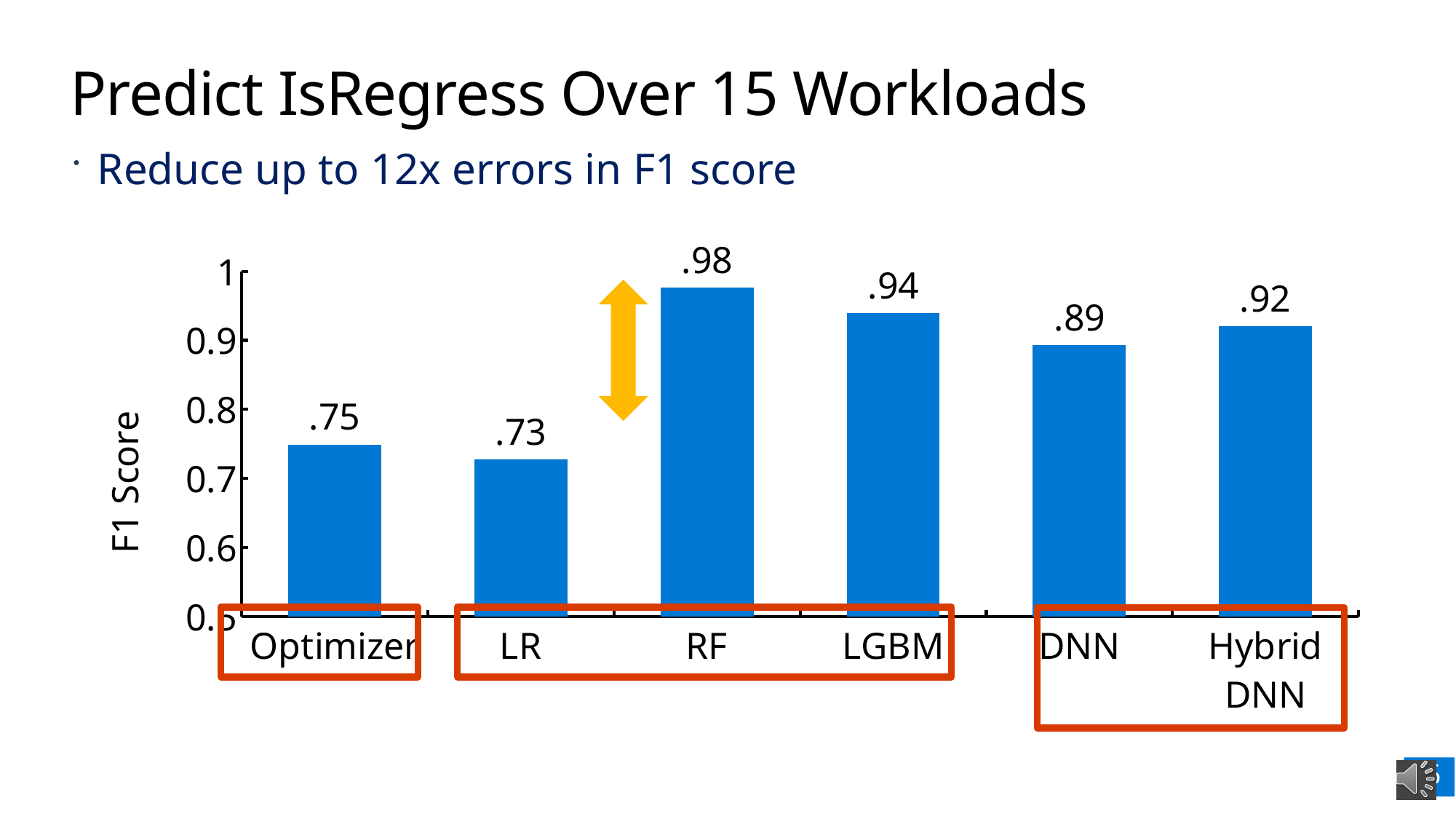
What is the F1 score for DNN? .89 What is the difference in F1 score between RF and LR? .25 Which category has the highest F1 score? RF Which category has the lowest F1 score? LR What is the F1 score for RF? .98 Is the F1 score for DNN greater or less than 0.8? greater What is the F1 score for Hybrid DNN? .92 How many categories are shown on the x axis? 6 What kind of chart is shown on the slide? bar chart What is the label of the y axis? F1 Score Which has a higher F1 score, LGBM or Hybrid DNN? LGBM What is the F1 score for Optimizer? .75